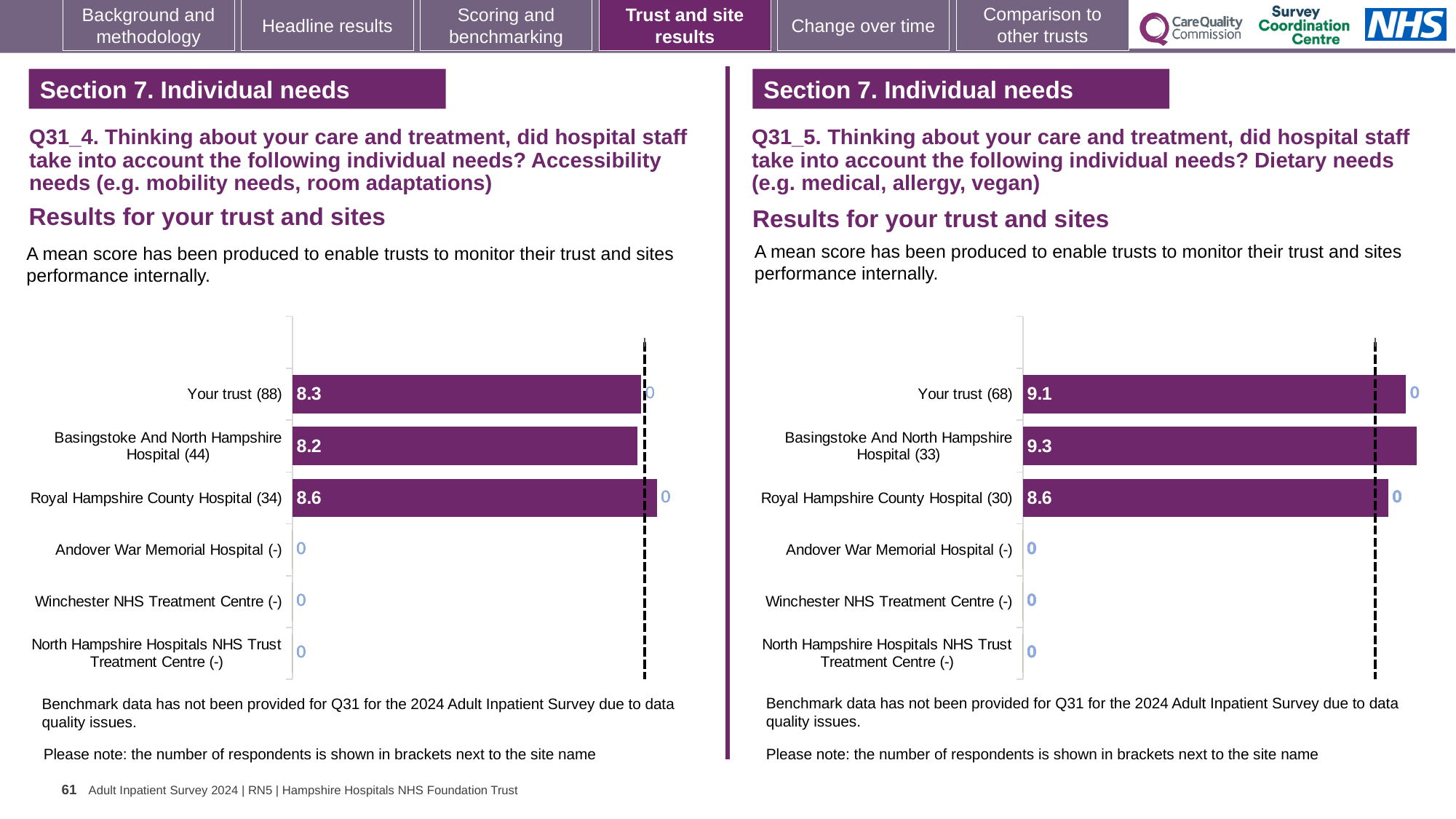
On the right chart (Q31_5, dietary needs), which site with a plotted score has the lowest mean score? Royal Hampshire County Hospital (30) On the left chart (Q31_4, accessibility needs), which site with a plotted score has the highest mean score? Royal Hampshire County Hospital (34) On the right chart (Q31_5, dietary needs), which has the larger mean score: Your trust (68) or Royal Hampshire County Hospital (30)? Your trust (68) What kind of chart is used on the right side of the slide (Q31_5, dietary needs)? Bar chart On the left chart (Q31_4, accessibility needs), what is the mean score for Your trust (88)? 8.3 On the left chart (Q31_4, accessibility needs), what is the difference between the mean scores for Royal Hampshire County Hospital (34) and Basingstoke And North Hampshire Hospital (44)? 0.4 On the right chart (Q31_5, dietary needs), what is the mean score for Basingstoke And North Hampshire Hospital (33)? 9.3 On the right chart (Q31_5, dietary needs), what is the difference between the mean scores for Basingstoke And North Hampshire Hospital (33) and Your trust (68)? 0.2 How many site categories are listed on the left chart (Q31_4, accessibility needs)? 6 On the left chart (Q31_4, accessibility needs), what is the mean score for Royal Hampshire County Hospital (34)? 8.6 On the right chart (Q31_5, dietary needs), what is the mean score for Your trust (68)? 9.1 On the left chart (Q31_4, accessibility needs), how many respondents are shown in brackets for Basingstoke And North Hampshire Hospital? 44